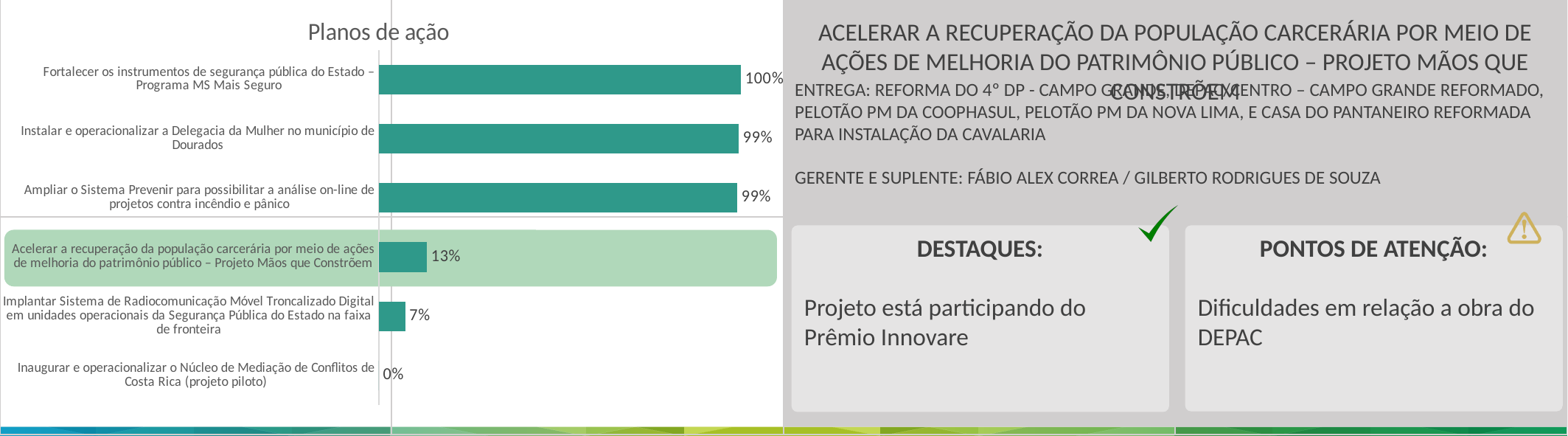
What is the title of the chart? Planos de ação What is the value for "Acelerar a recuperação da população carcerária por meio de ações de melhoria do patrimônio público – Projeto Mãos que Constrõem"? 13% What kind of chart is shown on the slide? Bar chart What is the value for "Implantar Sistema de Radiocomunicação Móvel Troncalizado Digital em unidades operacionais da Segurança Pública do Estado na faixa de fronteira"? 7% What is the value for "Inaugurar e operacionalizar o Núcleo de Mediação de Conflitos de Costa Rica (projeto piloto)"? 0% What is the difference between the value for "Instalar e operacionalizar a Delegacia da Mulher no município de Dourados" and the value for "Projeto Mãos que Constrõem"? 86% Which is larger: the value for "Projeto Mãos que Constrõem" or the value for "Implantar Sistema de Radiocomunicação Móvel Troncalizado Digital"? Projeto Mãos que Constrõem What is the value for "Ampliar o Sistema Prevenir para possibilitar a análise on-line de projetos contra incêndio e pânico"? 99% How many action plans (categories) are shown in the chart? 6 Which action plan has the lowest value in the chart? Inaugurar e operacionalizar o Núcleo de Mediação de Conflitos de Costa Rica (projeto piloto) What is the value for "Fortalecer os instrumentos de segurança pública do Estado – Programa MS Mais Seguro"? 100% Which action plan has the highest value in the chart? Fortalecer os instrumentos de segurança pública do Estado – Programa MS Mais Seguro